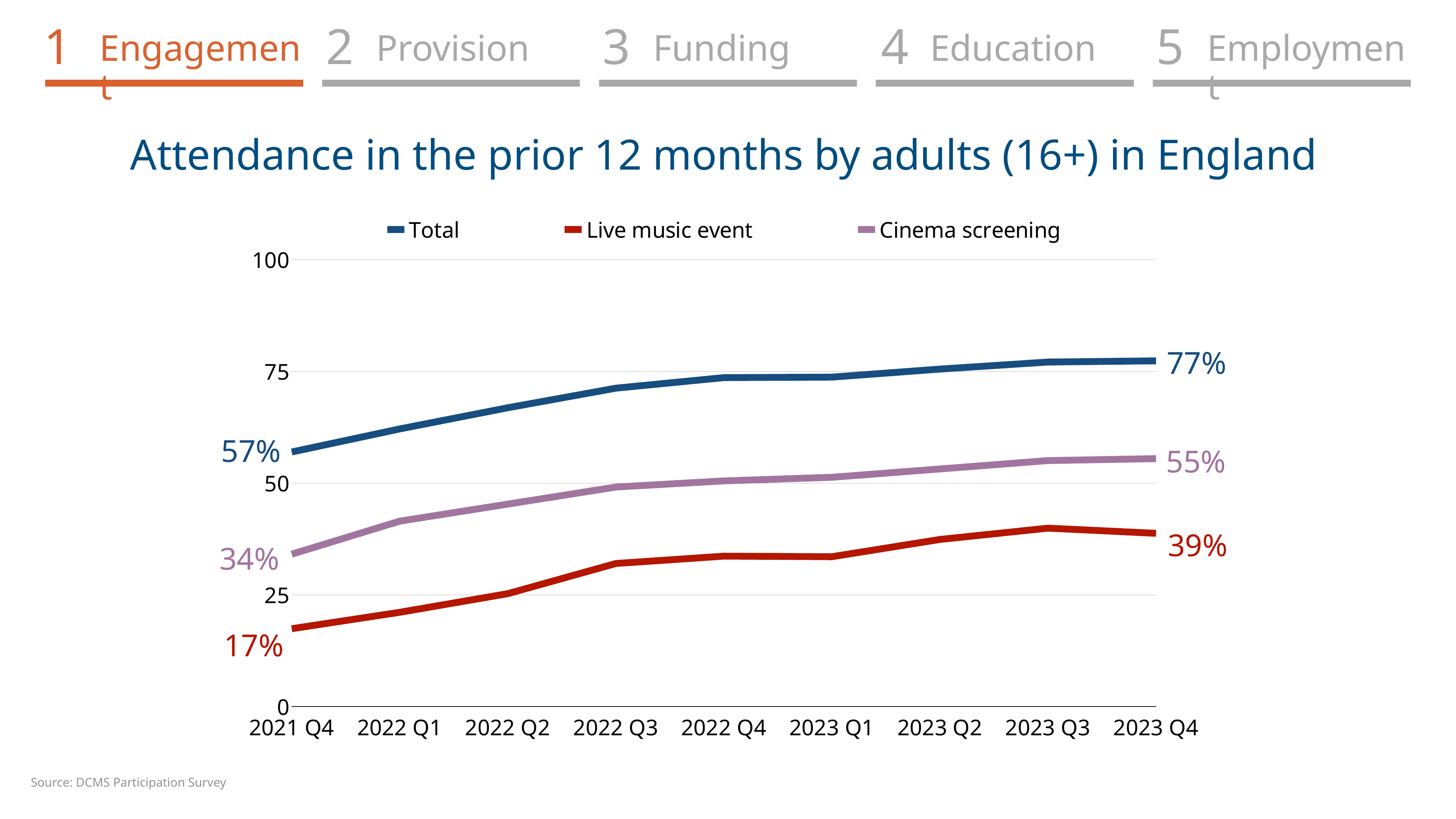
How many quarters are shown on the x axis? 9 By how many percentage points did Live music event change from 2021 Q4 to 2023 Q4? 22 By how many percentage points did Total change from 2021 Q4 to 2023 Q4? 20 How many series does the legend list? 3 Is the value for Total in 2022 Q3 greater or less than 50? greater What is the value for Total in 2021 Q4? 57% Is the value for Live music event in 2022 Q2 greater or less than 50? less What is the value for Total in 2023 Q4? 77% What is the value for Cinema screening in 2023 Q4? 55% What kind of chart is shown on the slide? Line chart What is the value for Live music event in 2021 Q4? 17% Which is larger in 2023 Q4: Cinema screening or Live music event? Cinema screening